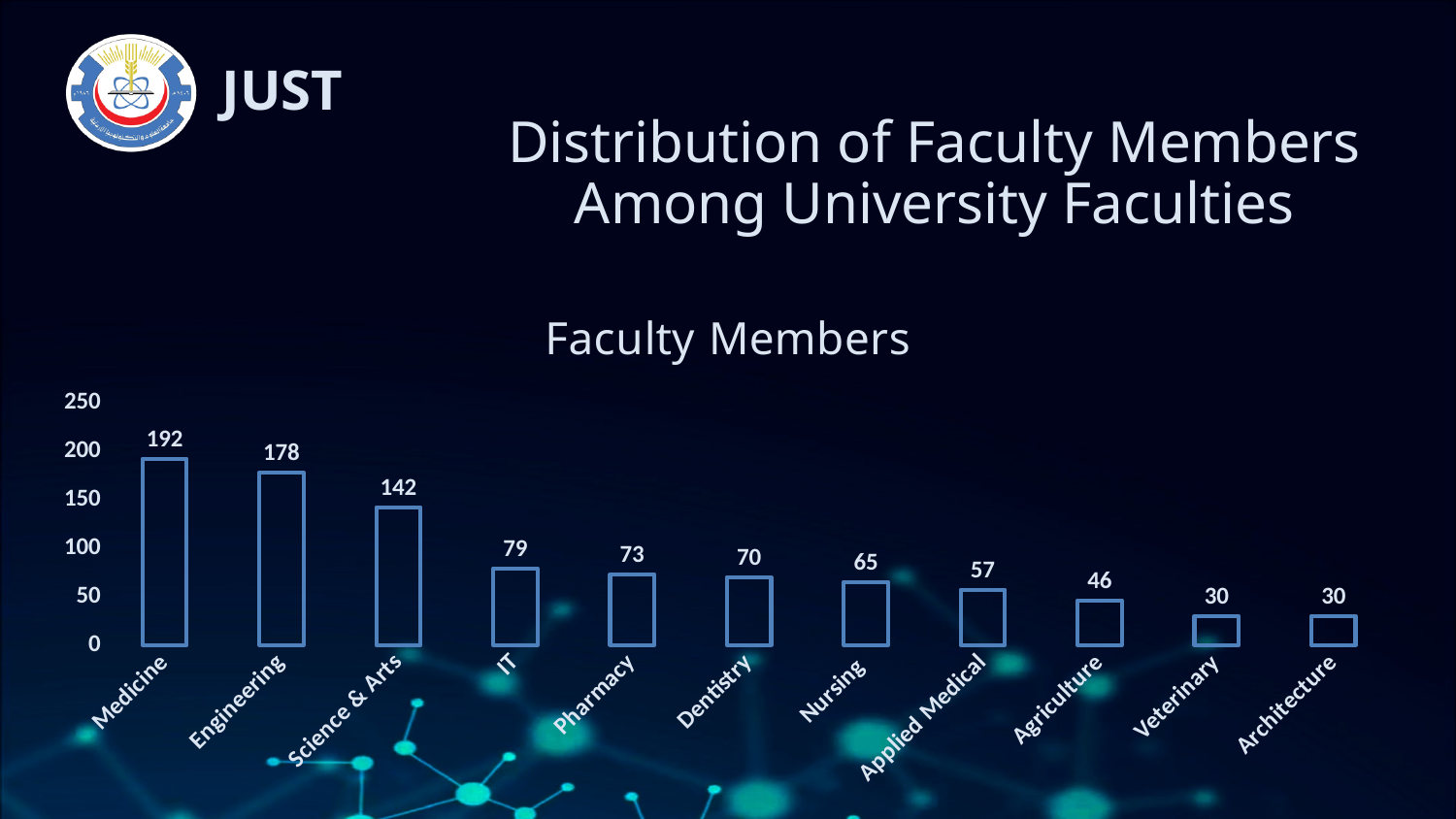
How many faculty members does Medicine have? 192 What is the value for Applied Medical? 57 Which faculty has the highest number of faculty members? Medicine What kind of chart is shown? bar chart What is the difference between Medicine and Engineering? 14 How many faculties are shown on the chart? 11 Which has more faculty members, Pharmacy or Nursing? Pharmacy What is the title of the chart? Faculty Members Is the value for Dentistry greater or less than 100? less What is the difference between IT and Agriculture? 33 Which faculties have the lowest number of faculty members? Veterinary and Architecture What is the value for Science & Arts? 142